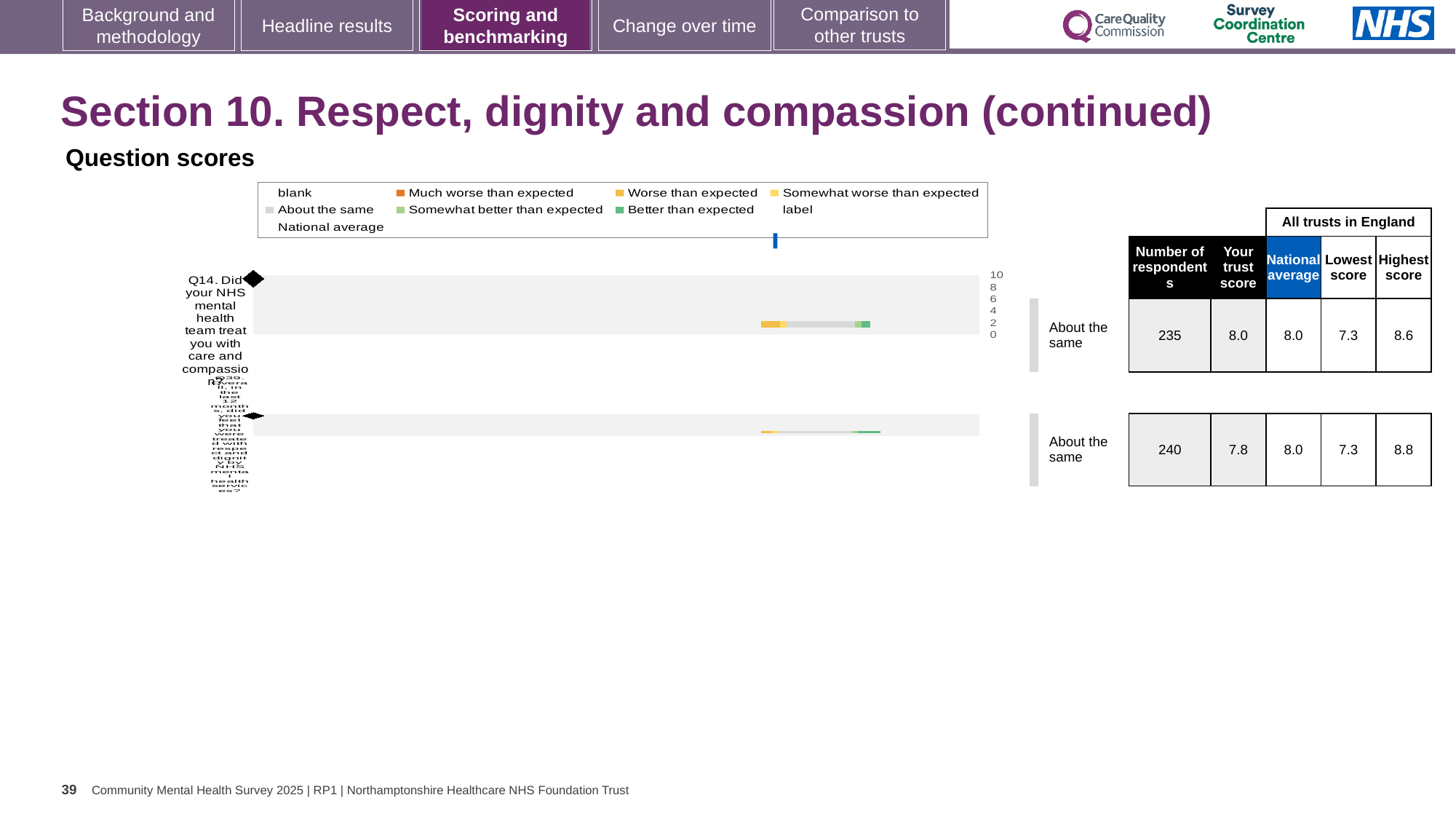
How many respondents answered Q14? 235 What is the trust score for Q39? 7.8 By how much is the trust score for Q39 below the national average? 0.2 What benchmark category is shown for both Q14 and Q39? About the same What is the difference between the highest and lowest scores for Q39? 1.5 What kind of chart is shown under 'Question scores'? bar chart Which question has the higher trust score, Q14 or Q39? Q14 What is the trust score for Q14 (Did your NHS mental health team treat you with care and compassion?)? 8.0 How many respondents answered Q39? 240 What is the highest score among all trusts in England for Q14? 8.6 How many questions are plotted in the chart? 2 What is the lowest score among all trusts in England for Q39? 7.3